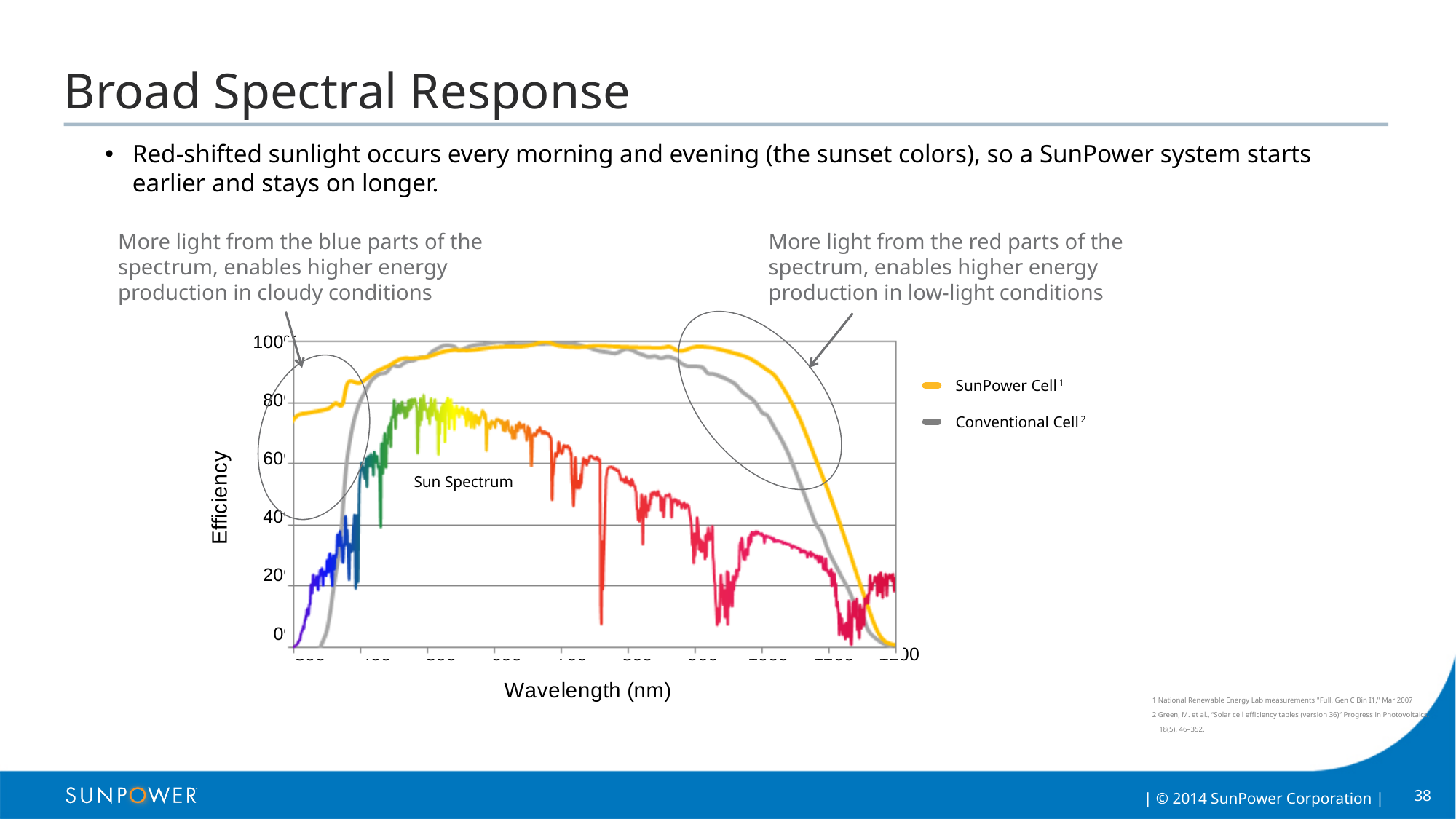
What kind of chart is shown on the slide? line chart Between the left edge of the chart and about 500 nm, does the Conventional Cell line rise or fall? rise What are the two series named in the chart's legend? SunPower Cell and Conventional Cell Is the efficiency of the Conventional Cell at the left edge of the chart greater or less than 20? less What colour is the SunPower Cell line in the chart? orange Toward the right end of the x axis, does the SunPower Cell line rise or fall? fall At around 1100 nm, which series has the higher efficiency, SunPower Cell or Conventional Cell? SunPower Cell How many series does the chart's legend list? 2 Is the peak efficiency of the SunPower Cell line greater or less than 80? greater Is the efficiency of the SunPower Cell at the left edge of the chart greater or less than 60? greater On the right side of the chart, which series drops to zero efficiency at a shorter wavelength? Conventional Cell At the left edge of the chart (shortest wavelengths), which series has the higher efficiency, SunPower Cell or Conventional Cell? SunPower Cell